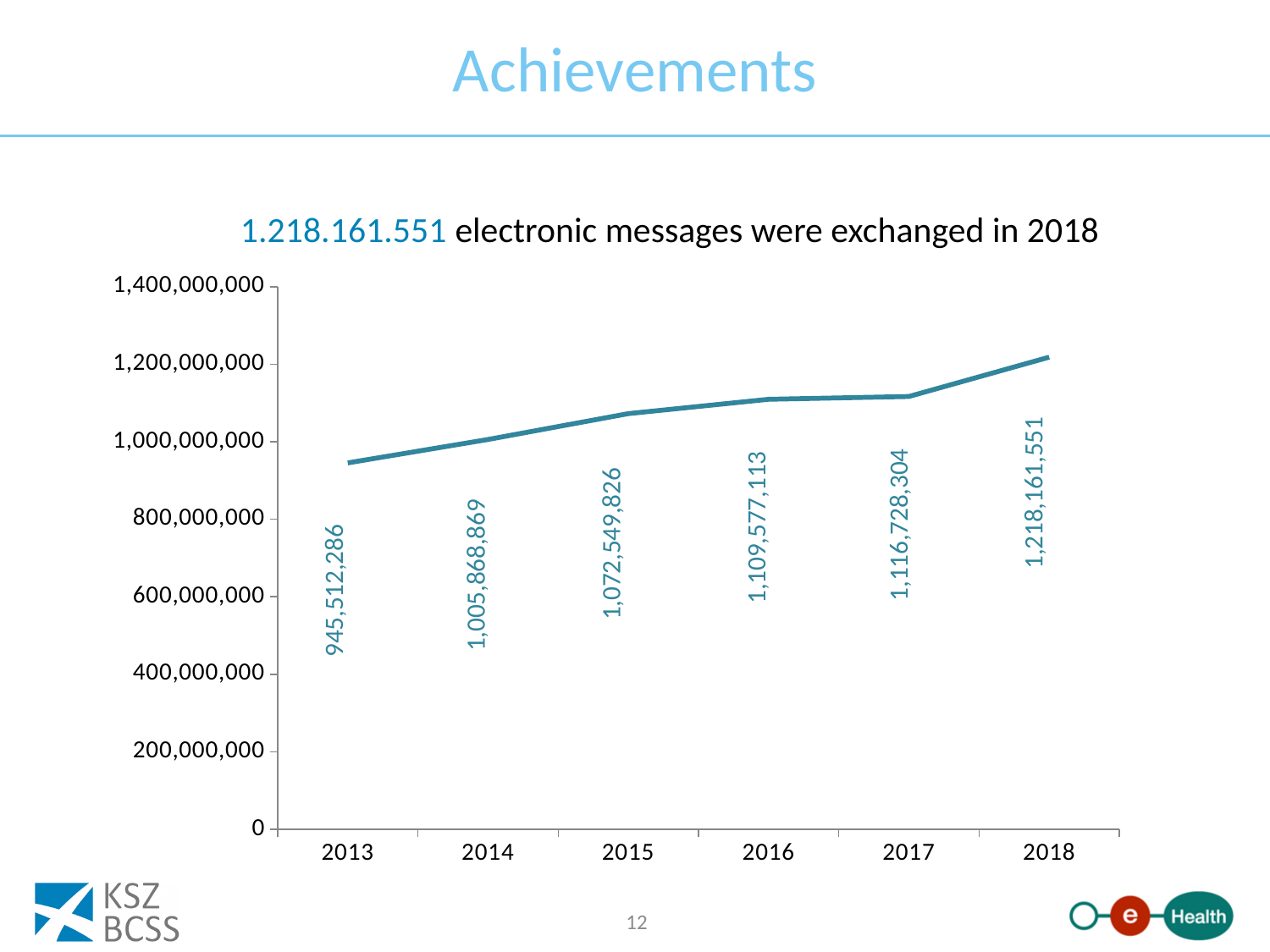
What is the difference between the values for 2018 and 2017? 101,433,247 Is the value for 2013 greater or less than 1,000,000,000? less Which year has the lowest value? 2013 Which is larger, the value for 2015 or the value for 2016? 2016 What is the difference between the values for 2014 and 2013? 60,356,583 What value is shown for 2016? 1,109,577,113 What kind of chart is shown on the slide? line chart What value is shown for 2018? 1,218,161,551 How many years are plotted on the x axis? 6 Do the values rise or fall from 2013 to 2018? rise Which year has the highest value? 2018 What value is shown for 2013? 945,512,286